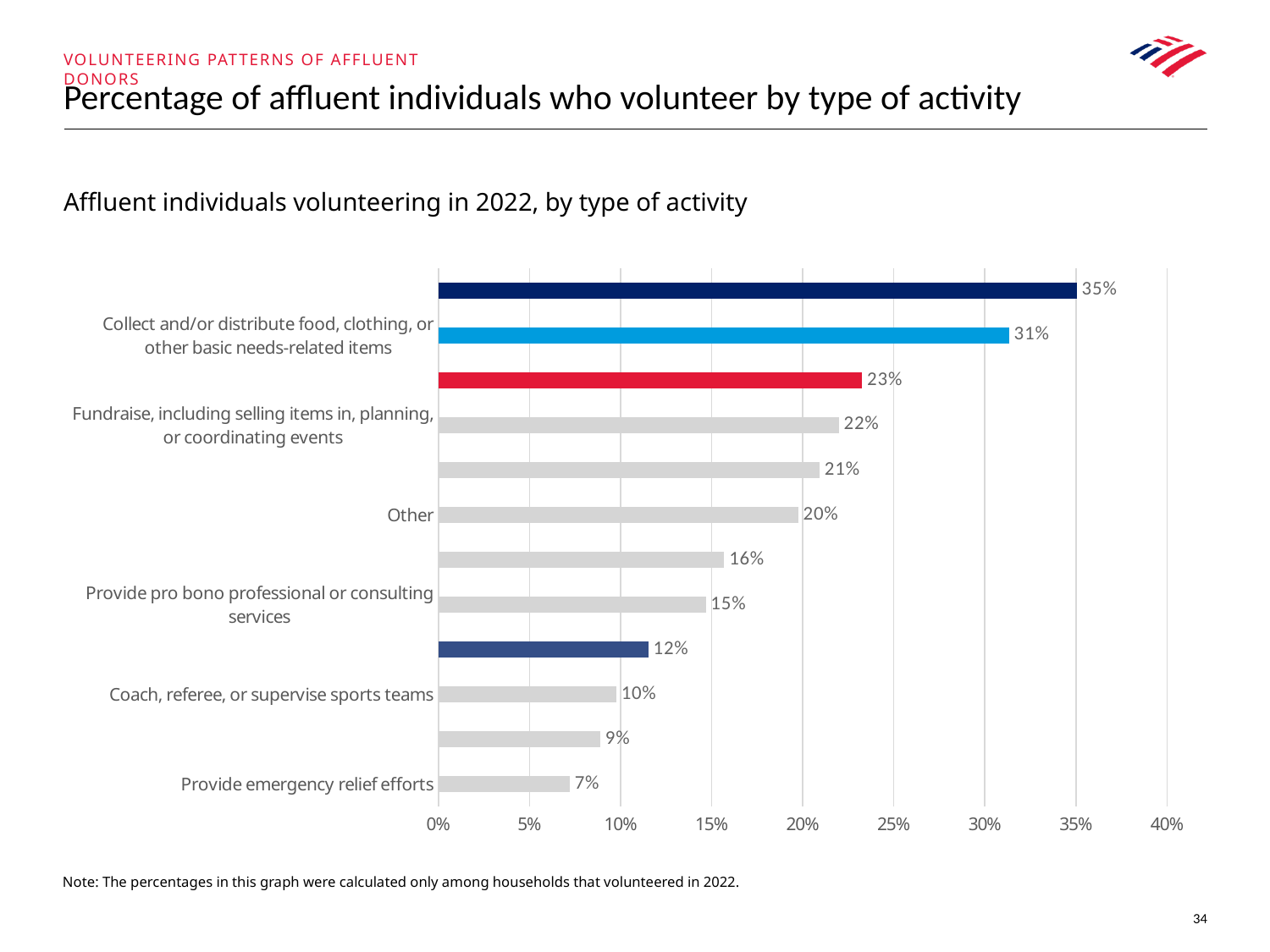
What is the value shown for 'Other'? 20% What percentage of affluent individuals provided emergency relief efforts? 7% What percentage of affluent individuals coached, refereed, or supervised sports teams? 10% What percentage of affluent individuals provided pro bono professional or consulting services? 15% Which is larger: the percentage for providing pro bono professional or consulting services or the percentage for coaching, refereeing, or supervising sports teams? Provide pro bono professional or consulting services What is the largest value shown on the chart? 35% What percentage of affluent individuals volunteered to fundraise, including selling items in, planning, or coordinating events? 22% What type of chart is shown on the slide? Bar chart Which labeled activity has the lowest percentage? Provide emergency relief efforts What is the difference between the percentage for collecting and/or distributing basic needs-related items and the percentage for fundraising? 9 percentage points How many bars are plotted on the chart? 12 What percentage of affluent individuals volunteered to collect and/or distribute food, clothing, or other basic needs-related items? 31%